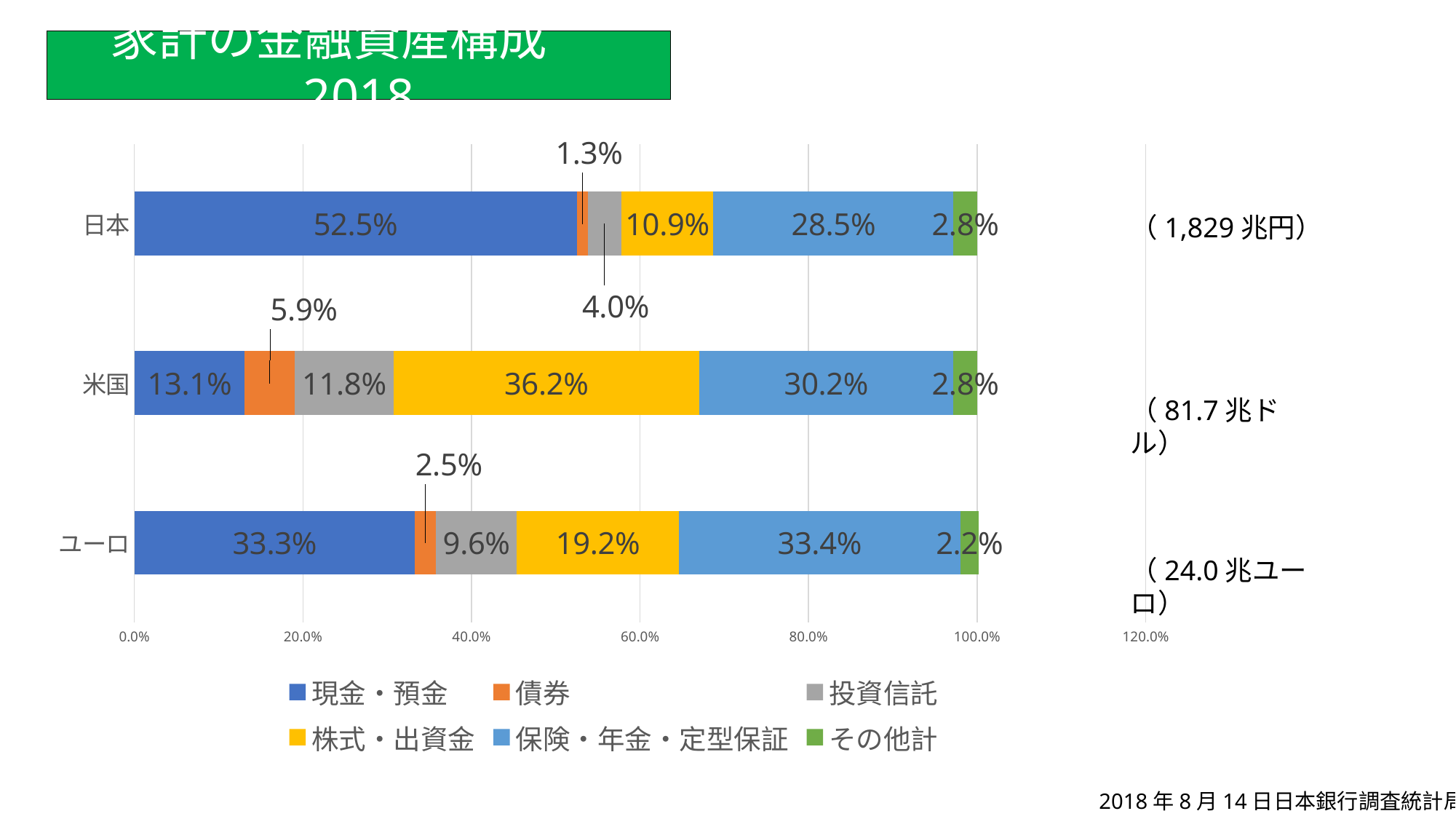
What is the value of 株式・出資金 for 米国? 36.2% What is the value of 投資信託 for 日本? 4.0% Which region has the lowest value for 株式・出資金? 日本 What is the difference between the 保険・年金・定型保証 values for 米国 and 日本? 1.7% Which region has the highest value for 現金・預金? 日本 Which legend entry is shown in orange? 債券 What kind of chart is shown on the slide? Stacked bar chart How many series does the legend list? 6 How many categories (regions) are plotted on the chart? 3 What is the value of 現金・預金 for 日本? 52.5% What is the value of 債券 for ユーロ? 2.5% Which is larger: 投資信託 for 米国 or 投資信託 for ユーロ? 米国